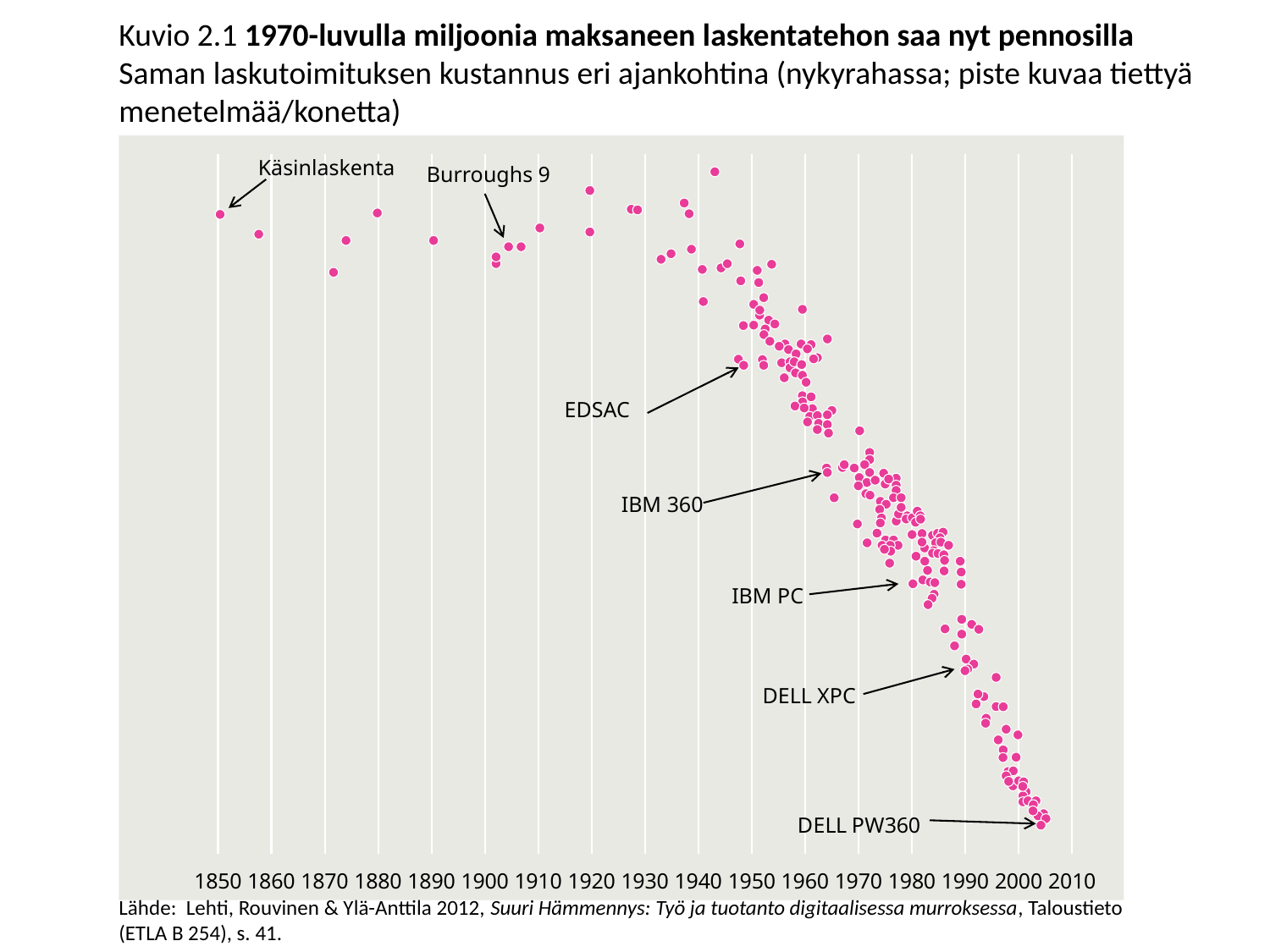
How many individual machines/methods are labelled with arrows on the chart? 7 Is the IBM PC point plotted before or after 1970 on the x axis? after What kind of chart is shown on the slide? scatter plot Which labelled point is plotted latest on the x axis? DELL PW360 Do the plotted points generally rise or fall from left to right after about 1950? fall What is the bold title of the chart (Kuvio 2.1)? 1970-luvulla miljoonia maksaneen laskentatehon saa nyt pennosilla What is the latest year labelled on the x axis? 2010 Is the Burroughs 9 point plotted before or after 1920 on the x axis? before Which is plotted higher on the chart, IBM 360 or IBM PC? IBM 360 Which labelled point is plotted lowest on the chart (lowest cost)? DELL PW360 What is the earliest year labelled on the x axis? 1850 Which labelled point is plotted earliest on the x axis? Käsinlaskenta